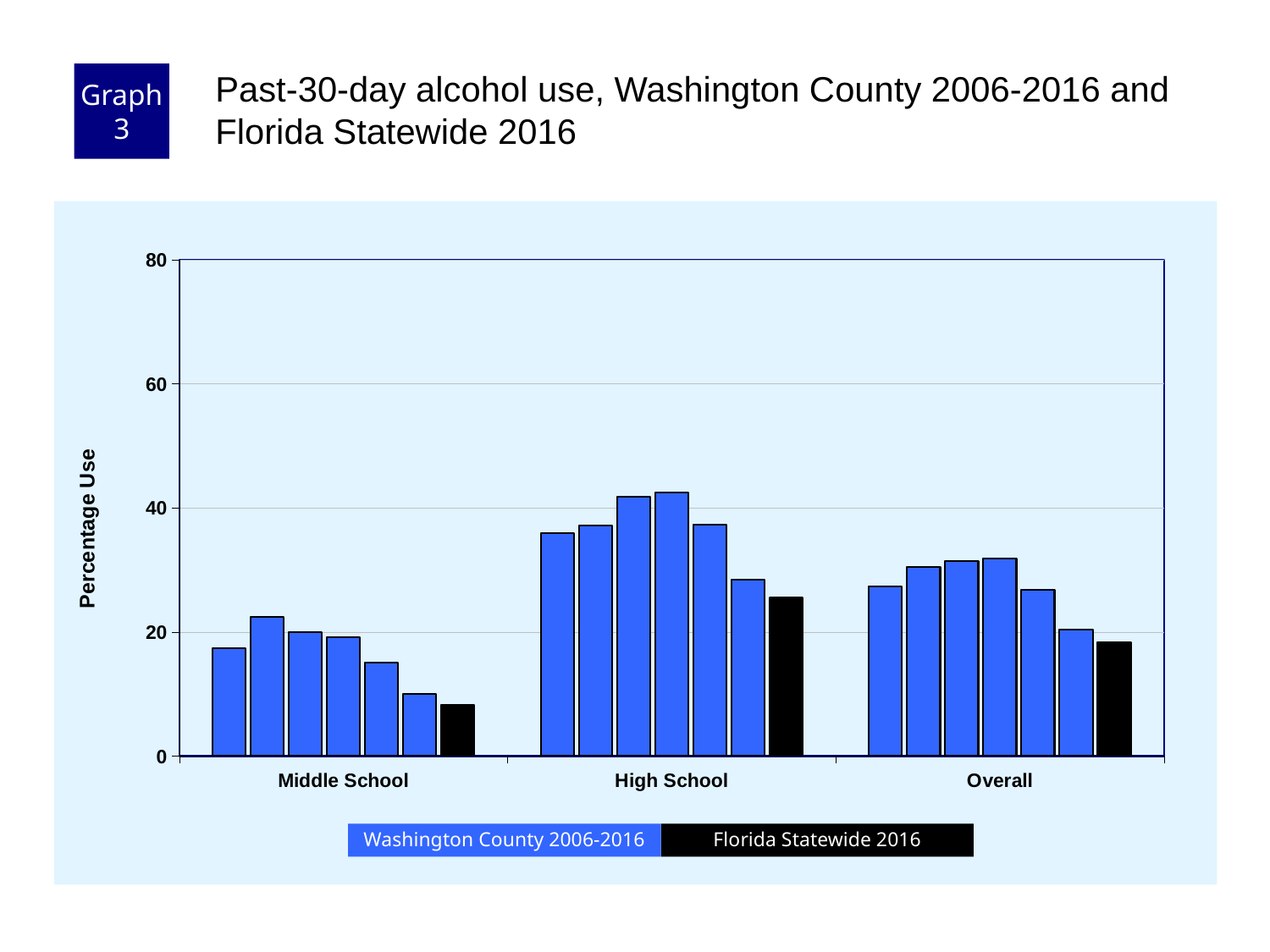
Which category has the lowest bars overall? Middle School Is the Florida Statewide 2016 value for High School greater or less than 20? greater How many school-level categories are shown on the x axis? 3 Which category has the highest bars overall? High School Within the High School group, is the rightmost Washington County bar higher or lower than the leftmost Washington County bar? lower What kind of chart is shown on the slide? bar chart Which colour represents Florida Statewide 2016 in the legend? black Is the tallest Washington County bar for High School greater or less than 40? greater Is the Florida Statewide 2016 value for Middle School greater or less than 20? less What is the label of the y axis? Percentage Use How many series does the legend list? 2 Which is larger, the Florida Statewide 2016 value for High School or for Middle School? High School